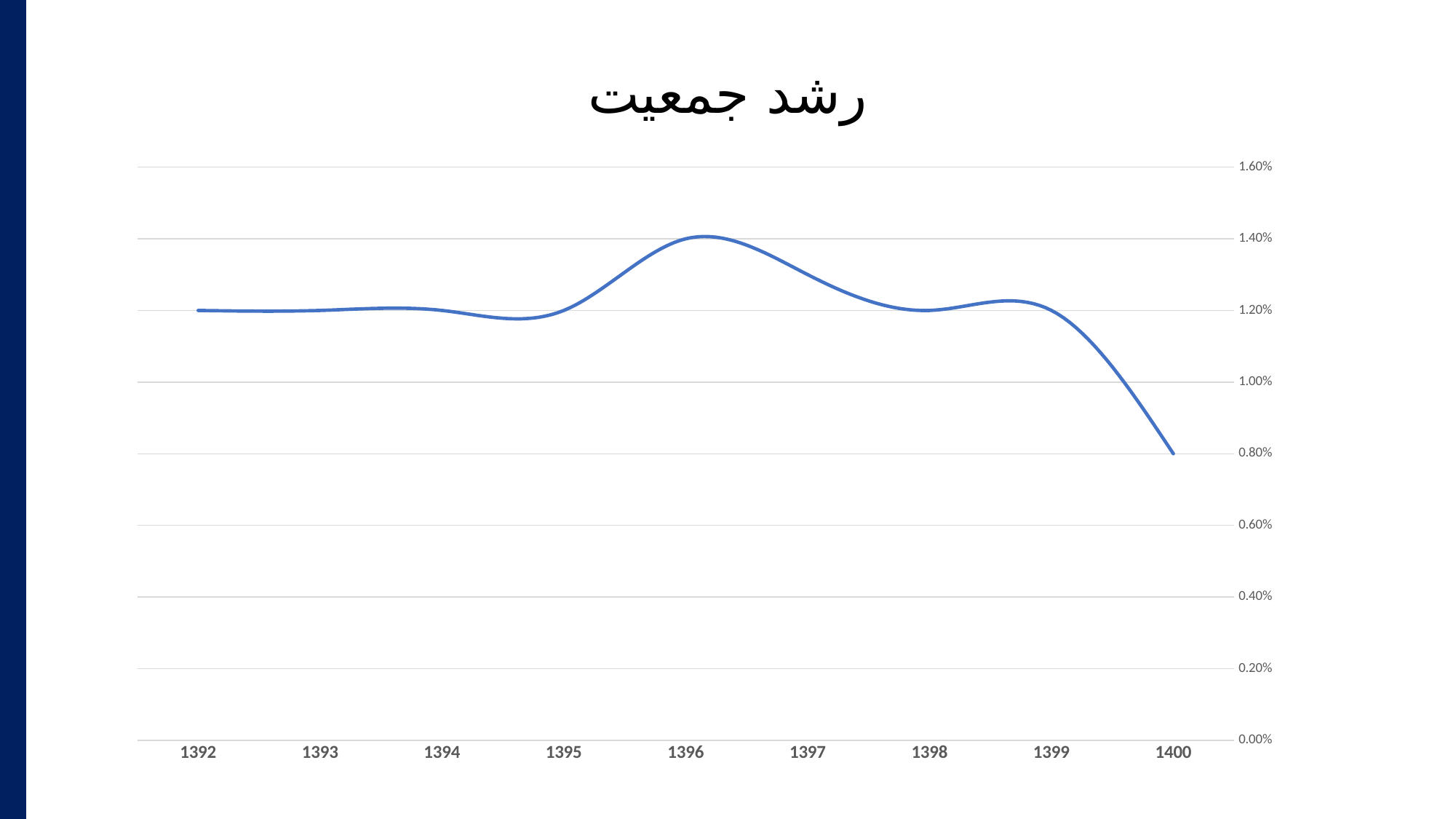
What kind of chart is shown on the slide? line chart What is the value for 1400? 0.80% How many years are plotted along the x axis? 9 What is the value for 1392? 1.20% Is the value for 1400 greater or less than 1.00%? less Is the value for 1396 greater or less than 1.20%? greater Which year has the highest value? 1396 What is the title of the chart? رشد جمعیت Does the value rise or fall between 1399 and 1400? fall Is the value for 1397 greater or less than 1.20%? greater Which is larger, the value for 1396 or the value for 1400? 1396 Which year has the lowest value? 1400